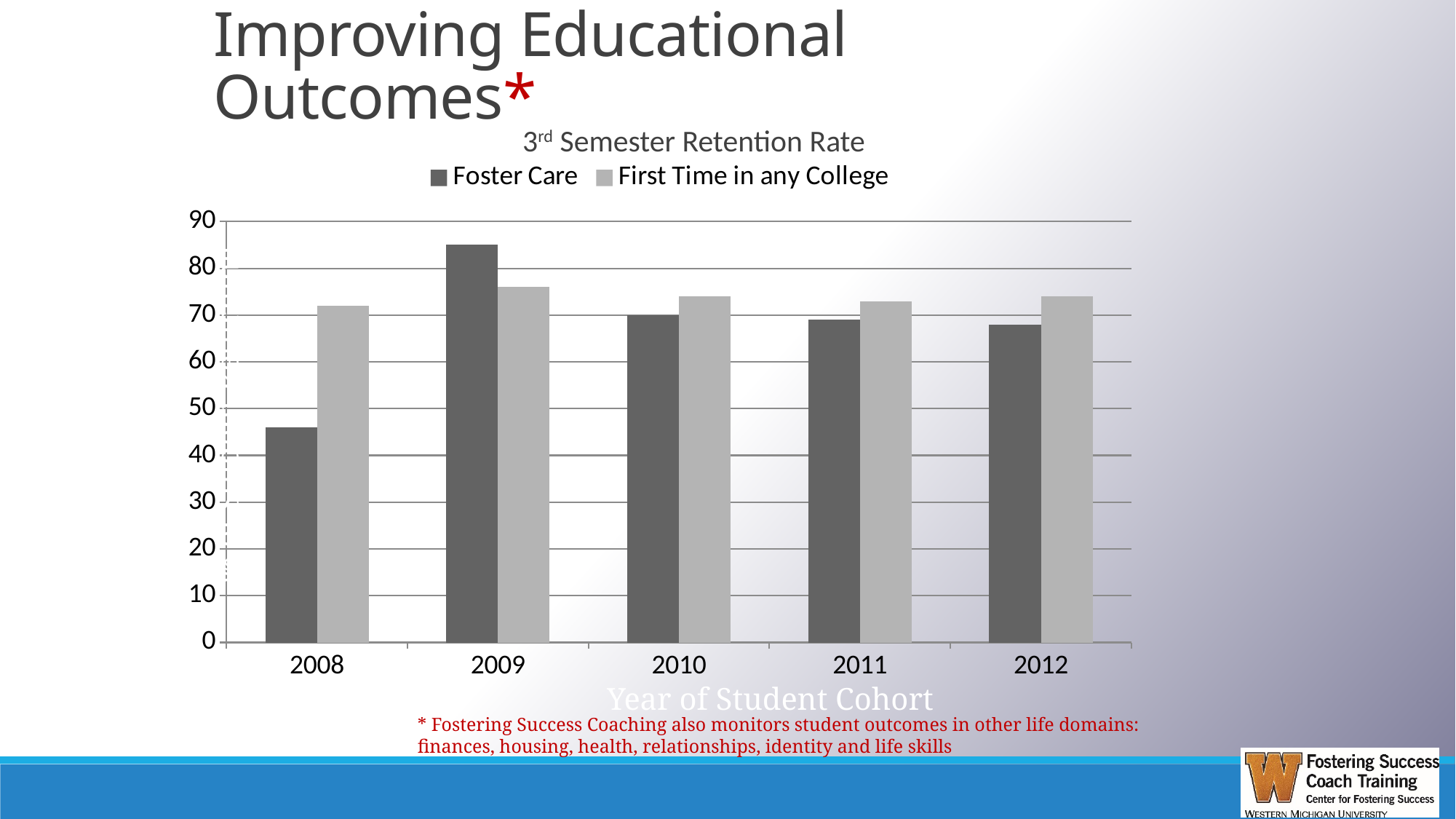
What kind of chart is shown on the slide? Bar chart In which year is the Foster Care retention rate highest? 2009 Is the First Time in any College value for 2008 greater or less than 70? greater In 2009, which is larger: Foster Care or First Time in any College? Foster Care Is the Foster Care value for 2008 greater or less than 50? less How many series does the legend list? 2 How many year cohorts are shown on the x axis? 5 Is the Foster Care value for 2009 greater or less than 80? greater In 2008, which is larger: Foster Care or First Time in any College? First Time in any College What is the title of the chart? 3rd Semester Retention Rate In which year is the Foster Care retention rate lowest? 2008